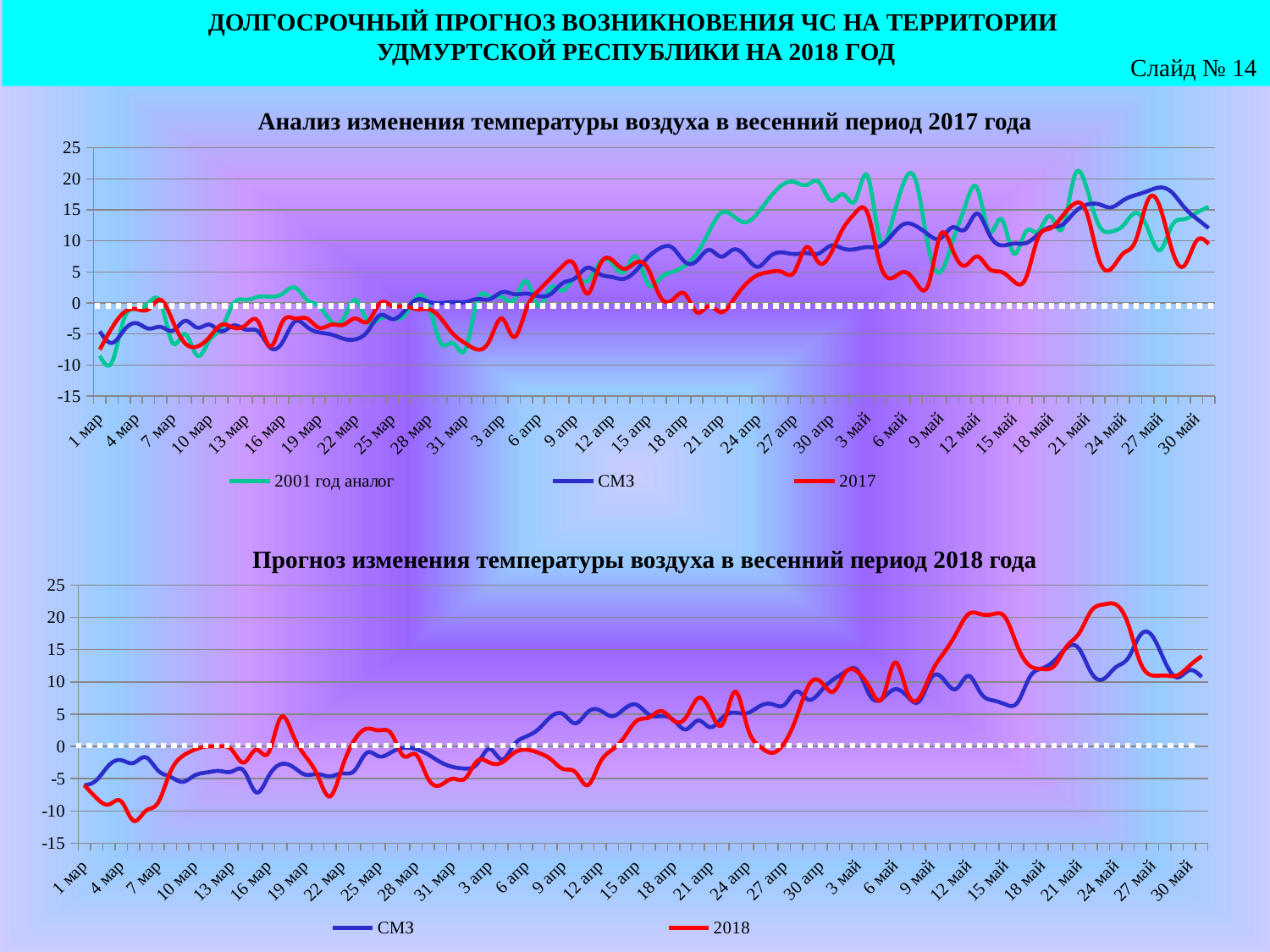
In the top chart (2017 analysis), which series is drawn in green? 2001 год аналог In the bottom chart (2018 forecast), is the value of the 2018 series around 4 мар greater or less than -5? less What kind of chart is the bottom chart titled "Прогноз изменения температуры воздуха в весенний период 2018 года"? Line chart In the bottom chart (2018 forecast), is the value of the 2018 series around 12 май greater or less than 15? greater How many series does the legend of the top chart (2017 analysis) list? 3 In the bottom chart (2018 forecast), do the values of the СМЗ series generally rise or fall from 1 мар to 30 май? rise In the bottom chart (2018 forecast), which series is drawn in red? 2018 How many series does the legend of the bottom chart (2018 forecast) list? 2 What kind of chart is the top chart titled "Анализ изменения температуры воздуха в весенний период 2017 года"? Line chart In the top chart (2017 analysis), is the value of the 2017 series at 1 мар greater or less than -5? less In the top chart (2017 analysis), do the values of the 2017 series generally rise or fall from 1 мар to 30 май? rise